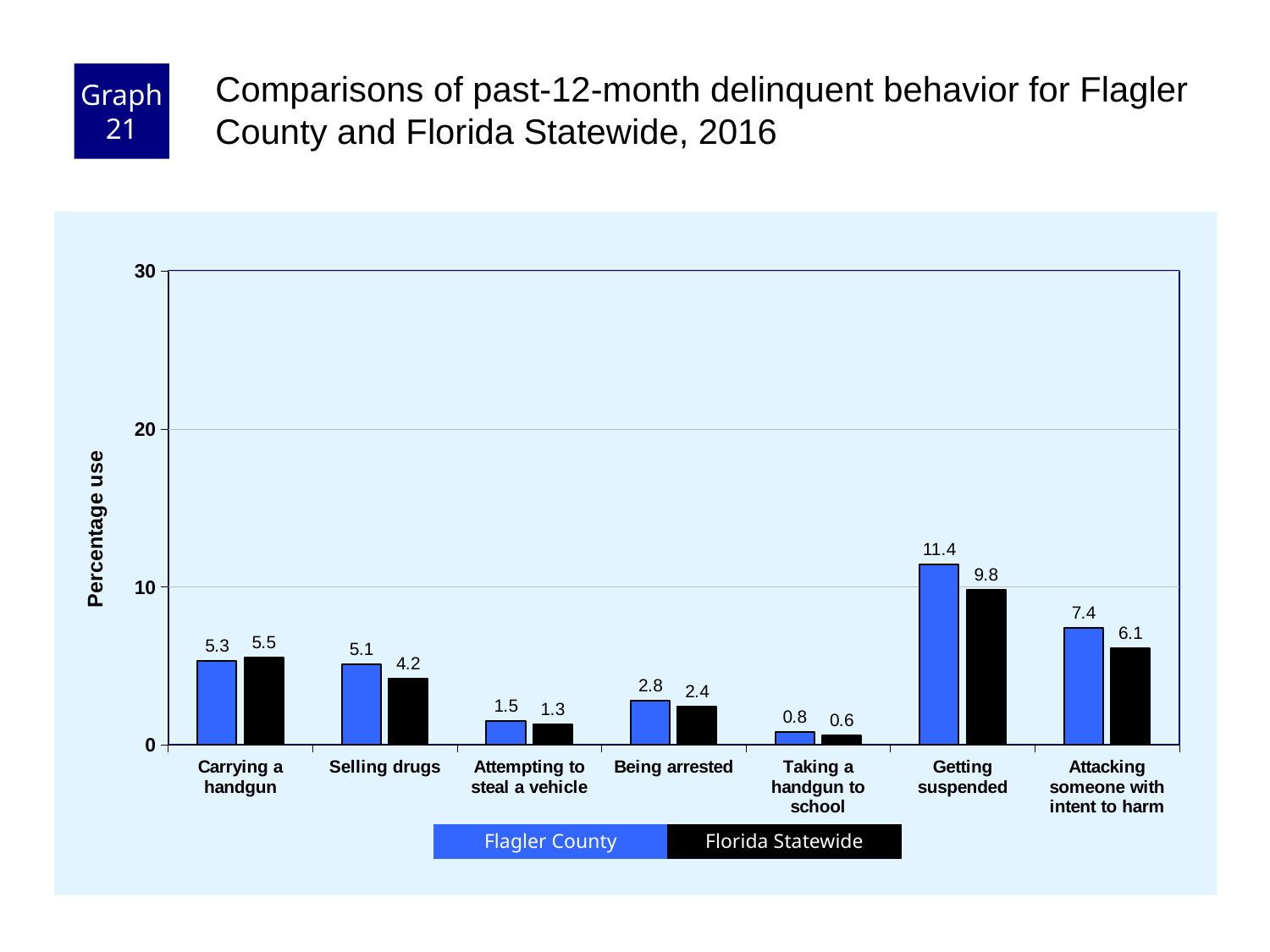
What is the difference between the Flagler County and Florida Statewide values for Attacking someone with intent to harm? 1.3 What is the label of the y axis? Percentage use What kind of chart is shown on the slide? bar chart Which category has the lowest Flagler County value? Taking a handgun to school What is the Florida Statewide value for Selling drugs? 4.2 How many categories are shown on the x axis? 7 How many series does the legend list? 2 Is the Flagler County value for Getting suspended greater or less than 10? greater What is the Flagler County value for Getting suspended? 11.4 Which category has the highest Florida Statewide value? Getting suspended What is the Flagler County value for Taking a handgun to school? 0.8 For Carrying a handgun, which is larger: the Flagler County value or the Florida Statewide value? Florida Statewide